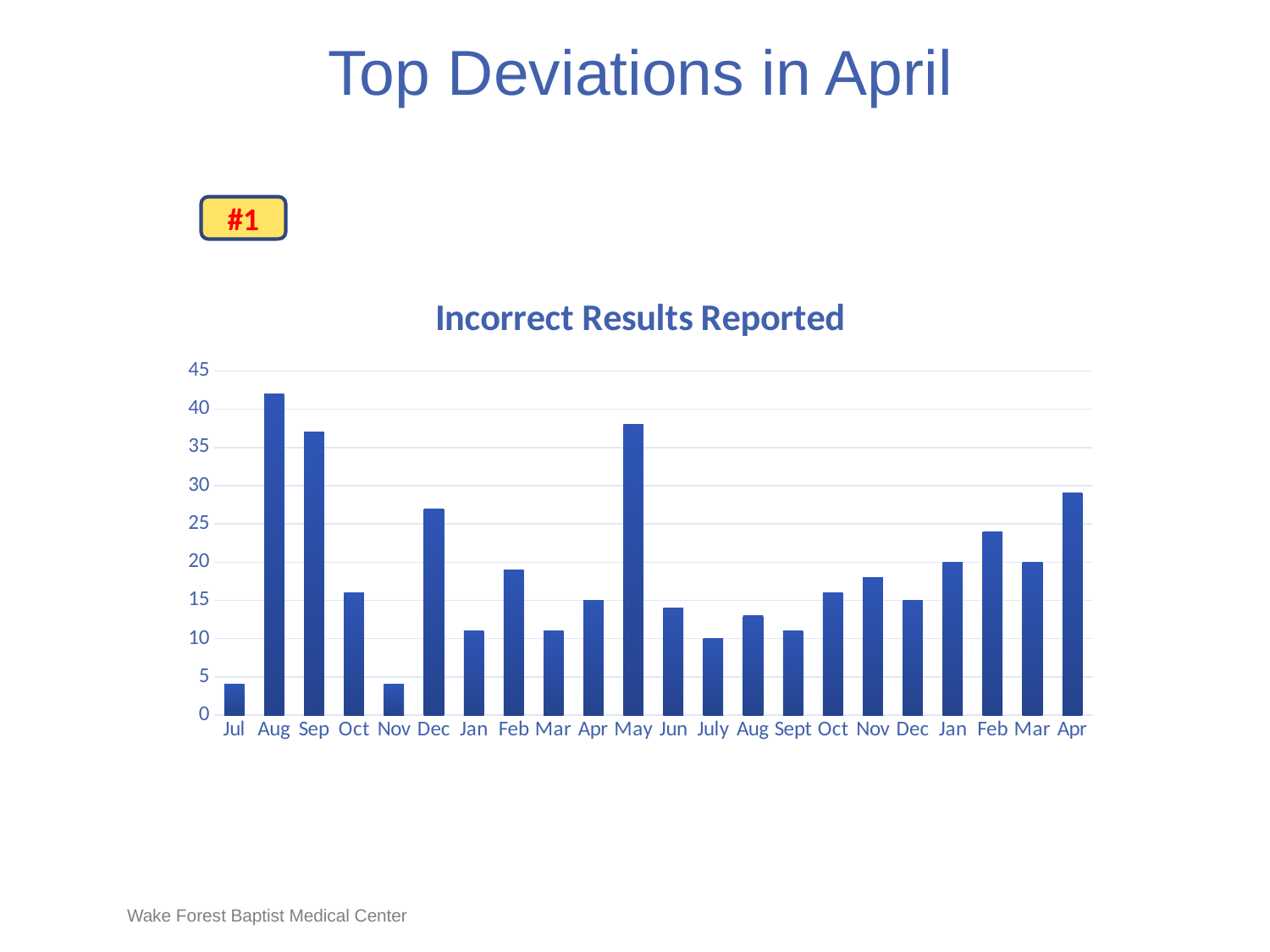
How many bars (categories) are plotted on the x axis of the chart? 22 Which is larger, the value for the second Feb bar or the second Nov bar? Feb Is the value for the May bar greater or less than 35? greater Is the value for the last Apr bar (rightmost) greater or less than 25? greater Which is larger, the value for the first Sep bar (third from left) or the first Dec bar (sixth from left)? Sep Is the value for the first Dec bar (sixth from left) greater or less than 25? greater What kind of chart is shown on the slide? bar chart What is the title of the chart? Incorrect Results Reported Which bar is the highest in the chart? the first Aug bar (second from left)